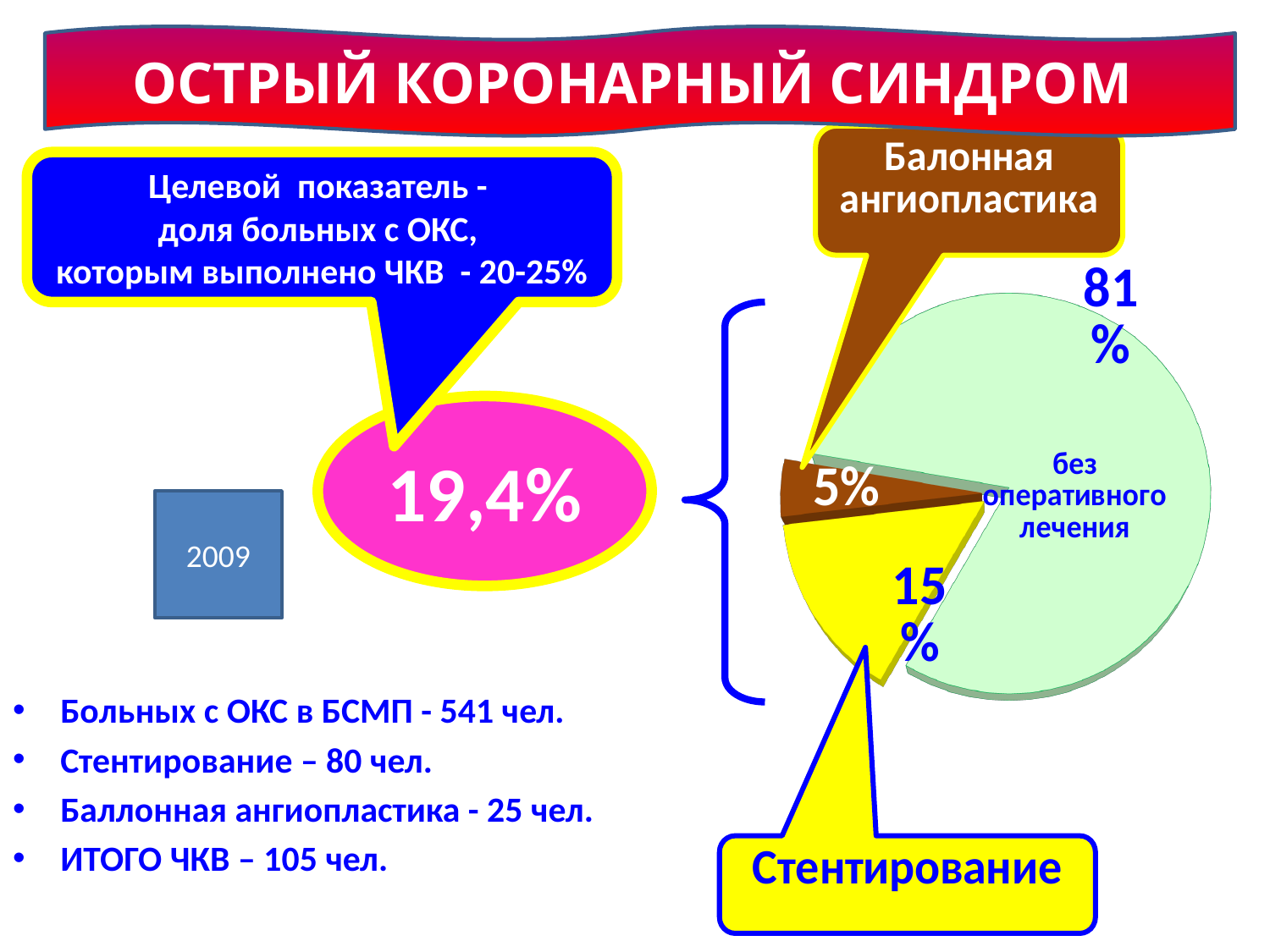
Which slice of the pie chart is the largest? без оперативного лечения Which slice of the pie chart is the smallest? Балонная ангиопластика How many slices does the pie chart have? 3 What share of the pie is labelled "без оперативного лечения"? 81% Which is larger in the pie chart: the "Стентирование" slice or the "Балонная ангиопластика" slice? Стентирование What kind of chart is shown on the slide? pie chart What colour is the "Балонная ангиопластика" slice in the pie chart? brown What share of the pie corresponds to "Стентирование"? 15% What colour is the "Стентирование" slice in the pie chart? yellow What is the difference between the "Стентирование" slice and the "Балонная ангиопластика" slice? 10 percentage points By how many percentage points does the "без оперативного лечения" slice exceed the "Стентирование" slice? 66 percentage points What share of the pie corresponds to "Балонная ангиопластика"? 5%